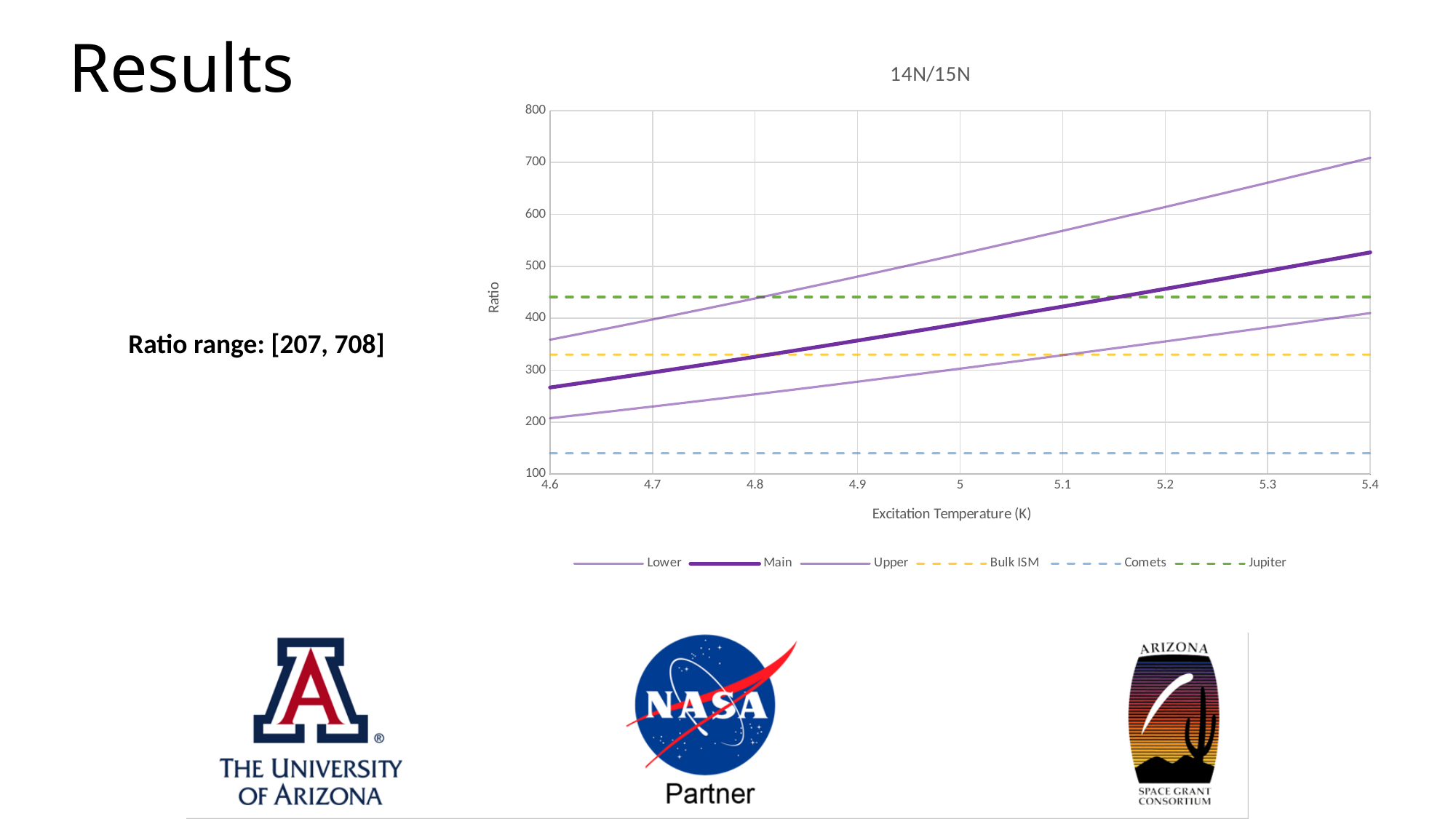
Which is larger, the Jupiter line or the Bulk ISM line? Jupiter Is the value of the Lower series at 4.6 K greater or less than 300? less How many series does the chart legend list? 6 What is the label of the x axis? Excitation Temperature (K) Is the Comets line greater or less than 200? less What kind of chart is shown on the slide? line chart Is the value of the Upper series at 5.4 K greater or less than 600? greater Does the Upper series rise or fall along the x axis? rise What is the title of the chart? 14N/15N Does the Main series rise or fall as excitation temperature increases? rise Which of the three horizontal reference lines (Bulk ISM, Comets, Jupiter) is the lowest? Comets